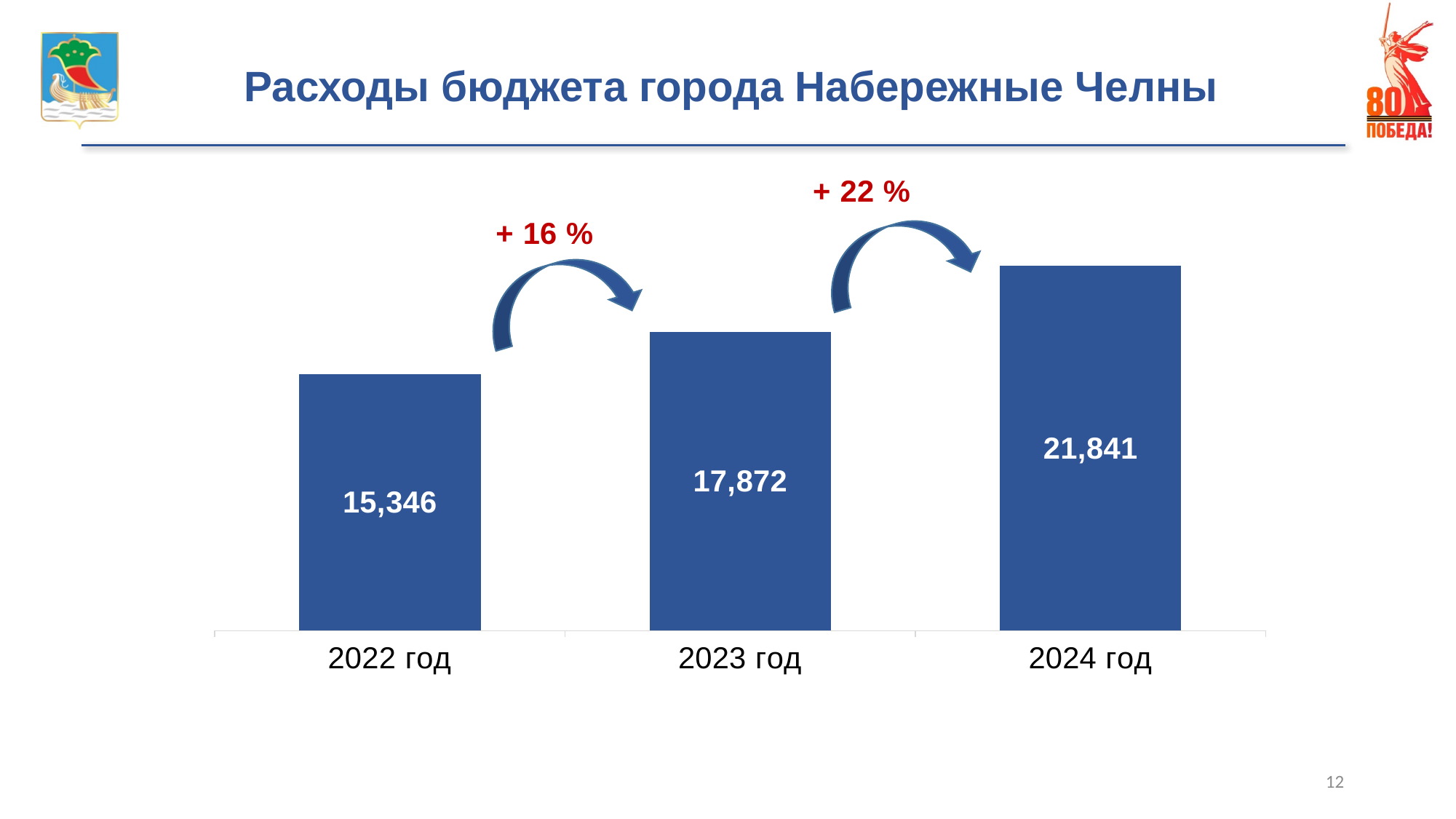
Which year has the lowest value? 2022 год What is the value for 2024 год? 21,841 What percentage increase is annotated between 2023 год and 2024 год? + 22 % Which is larger, the value for 2022 год or the value for 2024 год? 2024 год What is the difference between the values for 2023 год and 2022 год? 2,526 How many bars are shown in the chart? 3 Do the values rise or fall from 2022 год to 2024 год? Rise What kind of chart is shown on the slide? Bar chart Which year has the highest value? 2024 год What is the value for 2023 год? 17,872 What is the value for 2022 год? 15,346 What is the difference between the values for 2024 год and 2023 год? 3,969